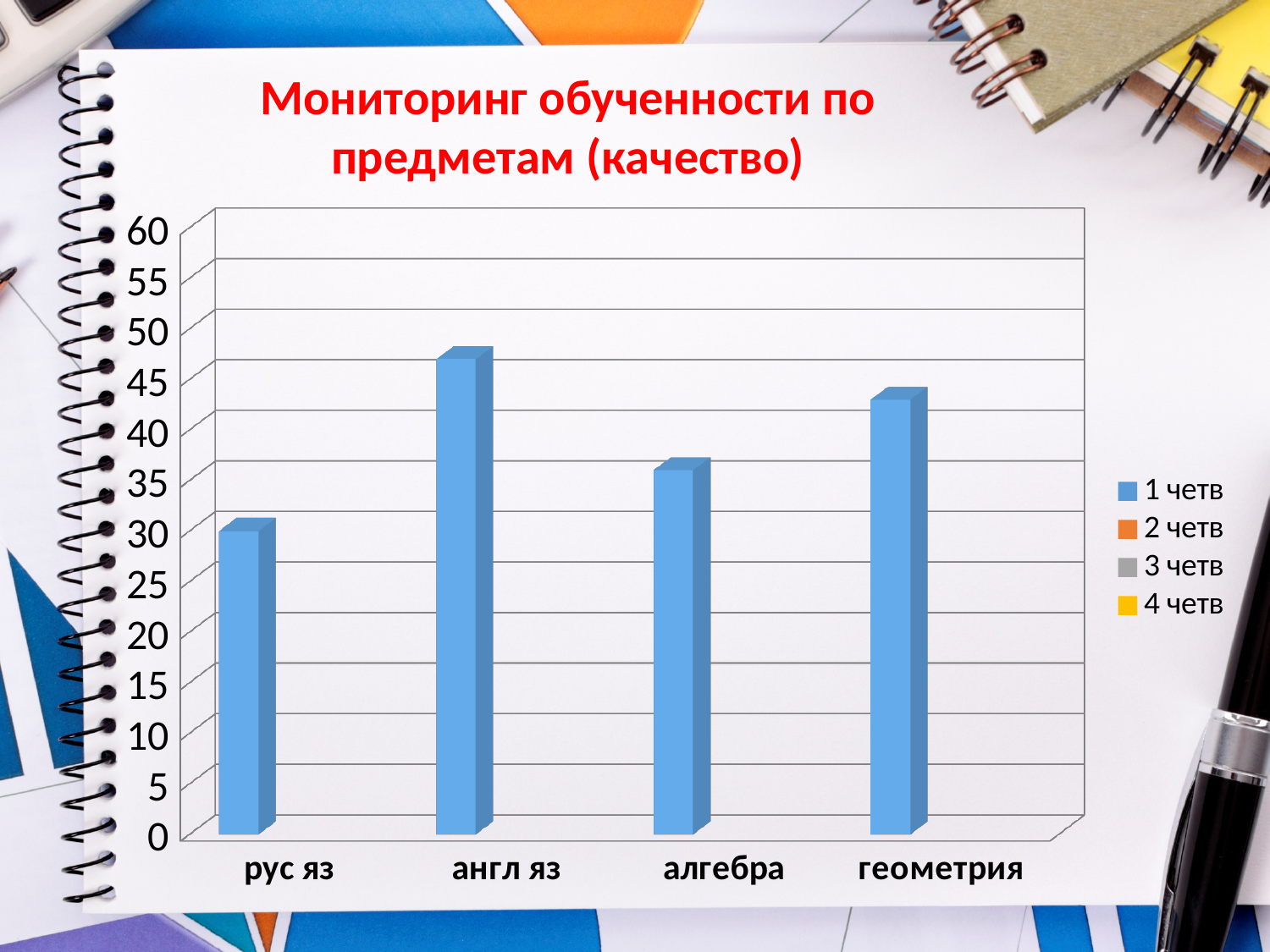
What kind of chart is shown on the slide? bar chart Which subject has the lowest bar? рус яз Is the value for рус яз greater or less than 40? less Which legend entry corresponds to the blue bars? 1 четв Which is larger, the value for англ яз or the value for рус яз? англ яз What is the title of the chart? Мониторинг обученности по предметам (качество) Is the value for англ яз greater or less than 40? greater Which is larger, the value for геометрия or the value for алгебра? геометрия Is the value for геометрия greater or less than 50? less How many series does the legend list? 4 Which subject has the highest bar? англ яз How many subject categories are shown on the x axis? 4